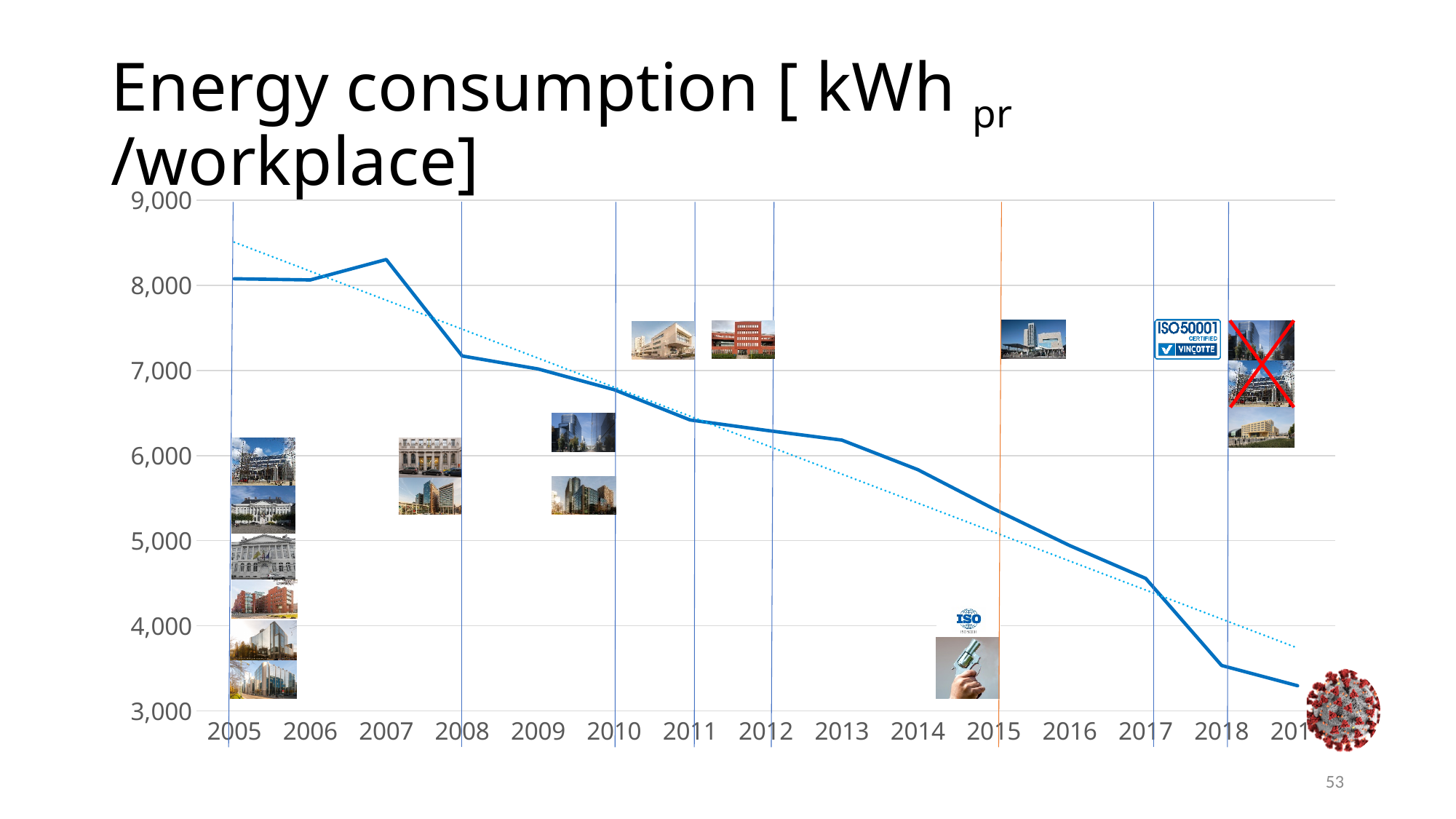
Is the value for 2018 greater or less than 4,000? less Overall, do the values rise or fall from 2005 to the end of the series? fall Which year has the highest energy consumption per workplace? 2007 What is the title of the chart on the slide? Energy consumption [ kWh pr /workplace] Is the value for 2008 greater or less than 7,000? greater Besides the solid line, what other kind of line is plotted on the chart? a dotted trend line Is the value for 2014 greater or less than 6,000? less Which is larger, the value for 2013 or the value for 2016? 2013 Which is larger, the value for 2007 or the value for 2008? 2007 What kind of chart is shown on the slide? line chart